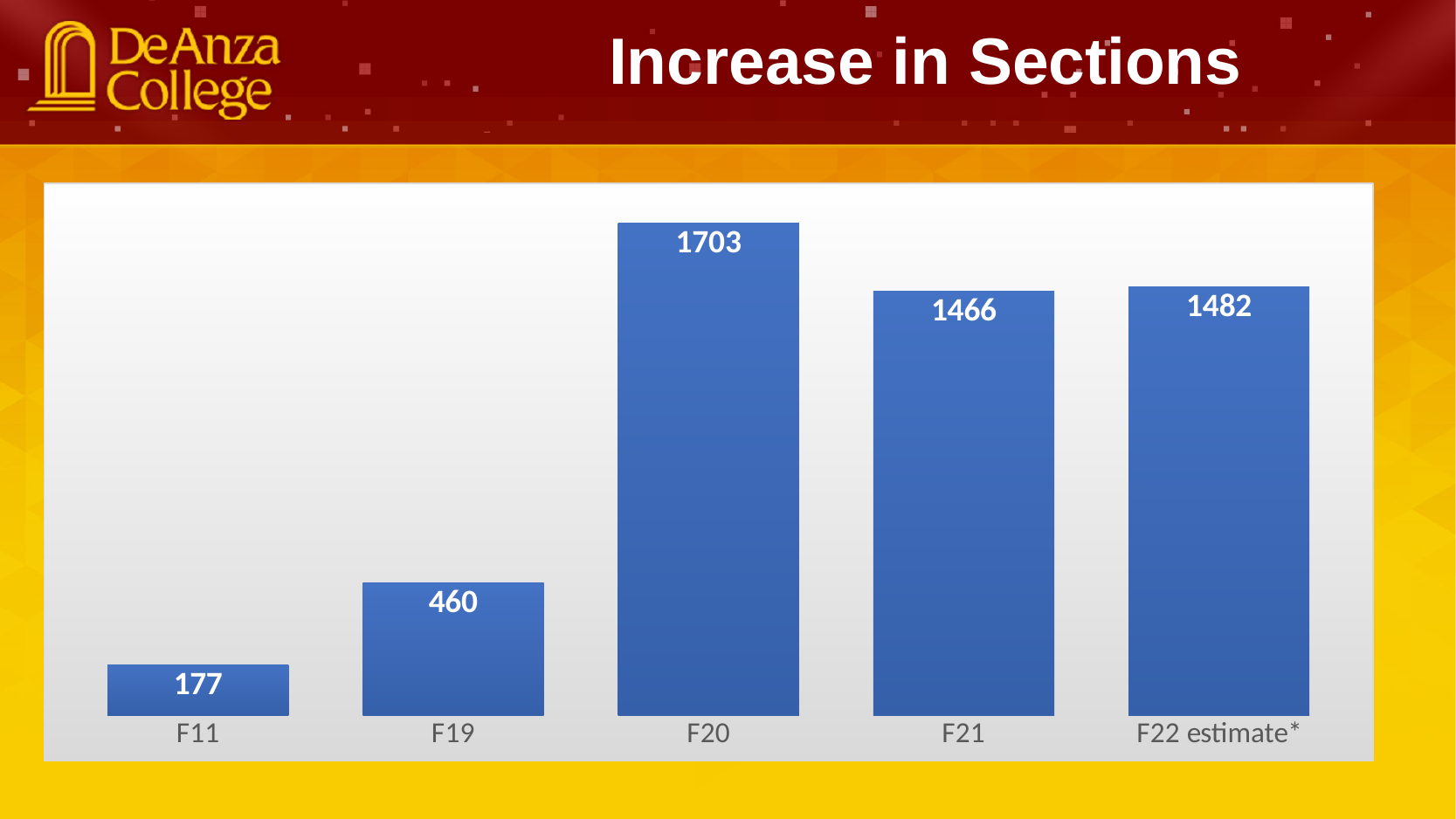
What is the value for F11? 177 Which category has the highest value? F20 What is the value for F19? 460 Which category has the lowest value? F11 What is the difference between the values for F20 and F21? 237 What kind of chart is shown on the slide? Bar chart Which is larger, the value for F22 estimate* or the value for F21? F22 estimate* What is the value for F21? 1466 What is the value for F20? 1703 How many categories are shown on the x axis? 5 What is the difference between the values for F19 and F11? 283 What is the value for F22 estimate*? 1482